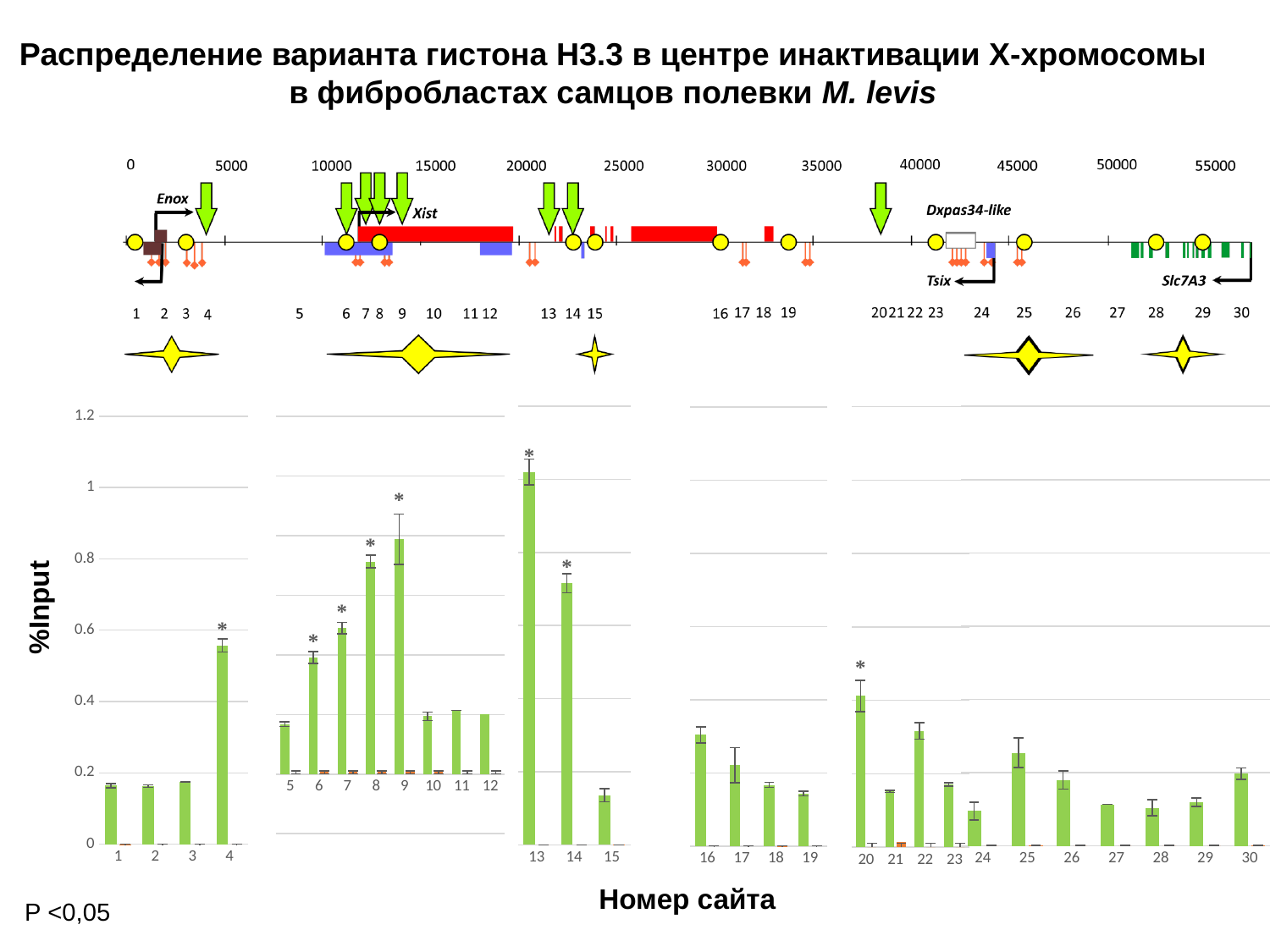
Do the %Input values rise or fall from site 16 to site 19? fall Is the %Input value for site 20 greater or less than 0.2? greater Which has the larger %Input value, site 4 or site 1? site 4 Is the %Input value for site 1 greater or less than 0.2? less Is the %Input value for site 14 greater or less than 0.6? greater What kind of chart is shown on the slide? bar chart What is the label of the x axis of the chart? Номер сайта Which site has the highest %Input value in the chart? 13 How many sites (categories) are plotted along the x axis of the chart? 30 Which has the larger %Input value, site 20 or site 21? site 20 What is the label of the y axis of the chart? %Input